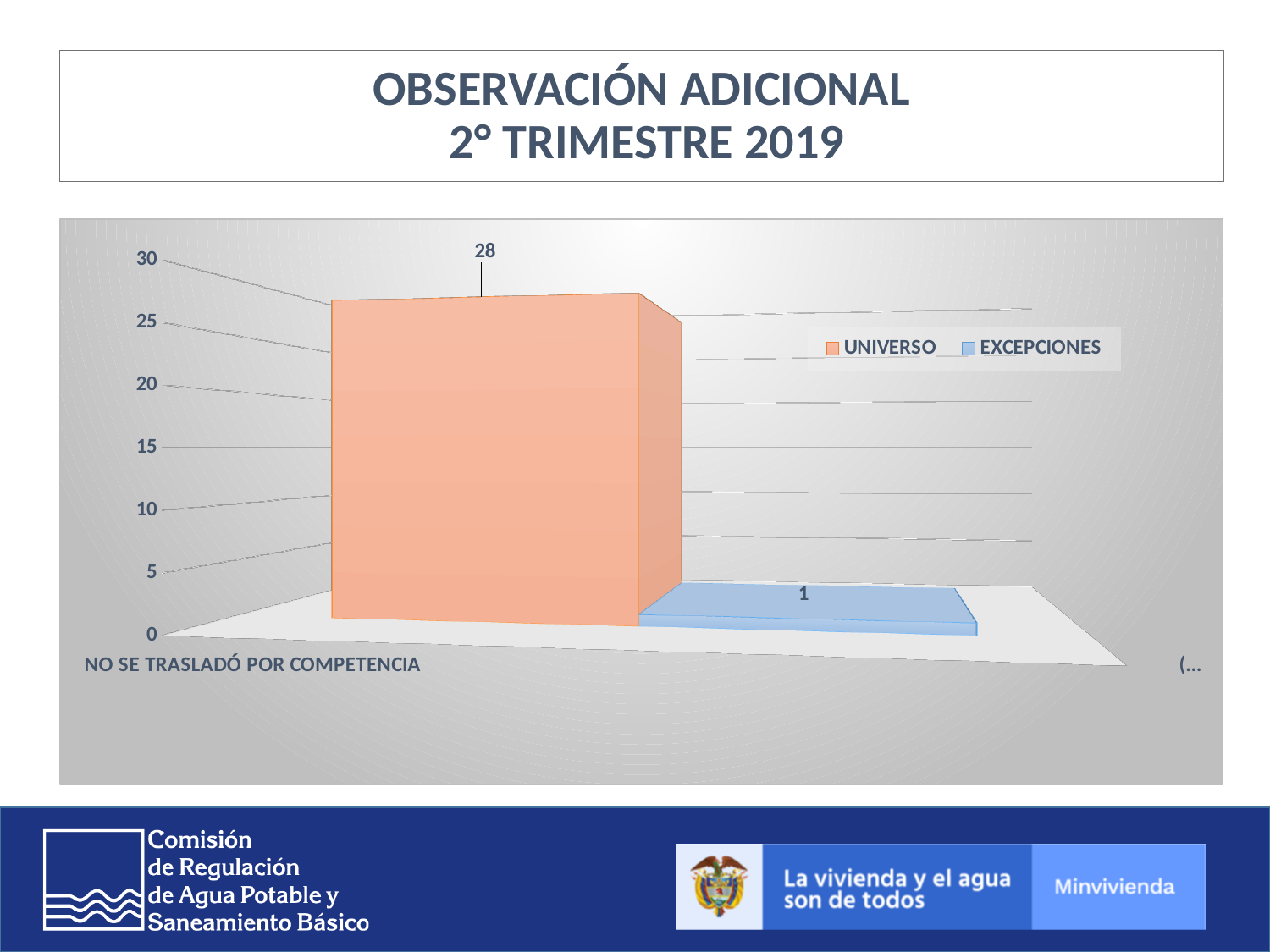
What is the value of the UNIVERSO series? 28 What kind of chart is shown on the slide? Bar chart Is the value for EXCEPCIONES greater or less than 5? less What colour is the UNIVERSO series in the chart? Orange What is the difference between the UNIVERSO value and the EXCEPCIONES value? 27 Which series has the lowest value? EXCEPCIONES How many series does the legend list? 2 What is the highest value shown on the vertical axis? 30 What is the value of the EXCEPCIONES series? 1 Which series has the higher value, UNIVERSO or EXCEPCIONES? UNIVERSO What is the title of the slide? OBSERVACIÓN ADICIONAL 2° TRIMESTRE 2019 Is the value for UNIVERSO greater or less than 25? greater